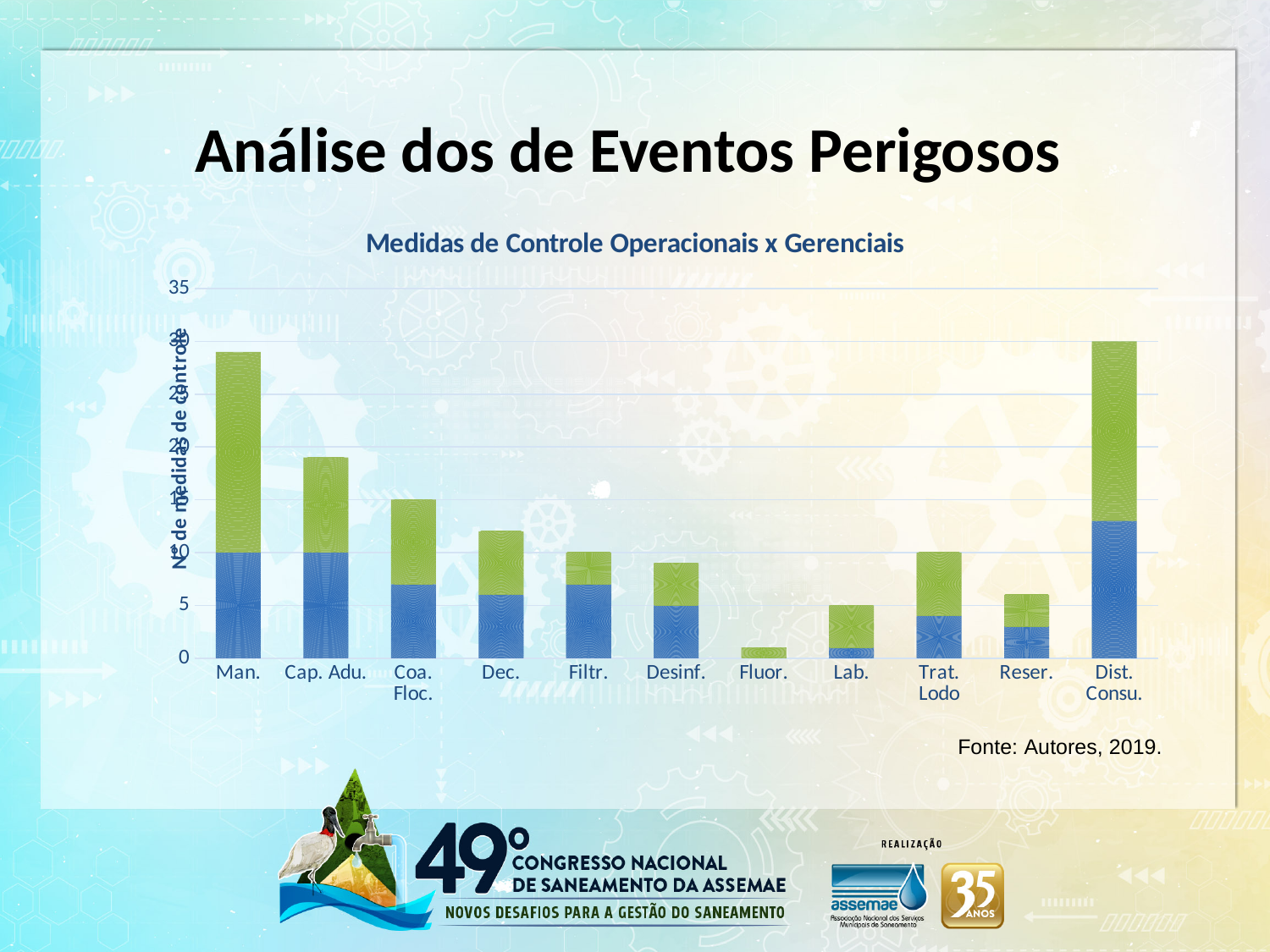
Is the total value for Fluor. greater or less than 5? less Which has the larger total bar, Dist. Consu. or Reser.? Dist. Consu. Which category has the lowest total bar in the chart? Fluor. How many categories are shown on the x axis of the chart? 11 Which has the larger total bar, Man. or Cap. Adu.? Man. Is the total value for Dec. greater or less than 10? greater Is the total value for Coa. Floc. greater or less than 10? greater Which has the larger total bar, Fluor. or Lab.? Lab. What kind of chart is shown on the slide? Stacked bar chart What is the title of the chart? Medidas de Controle Operacionais x Gerenciais